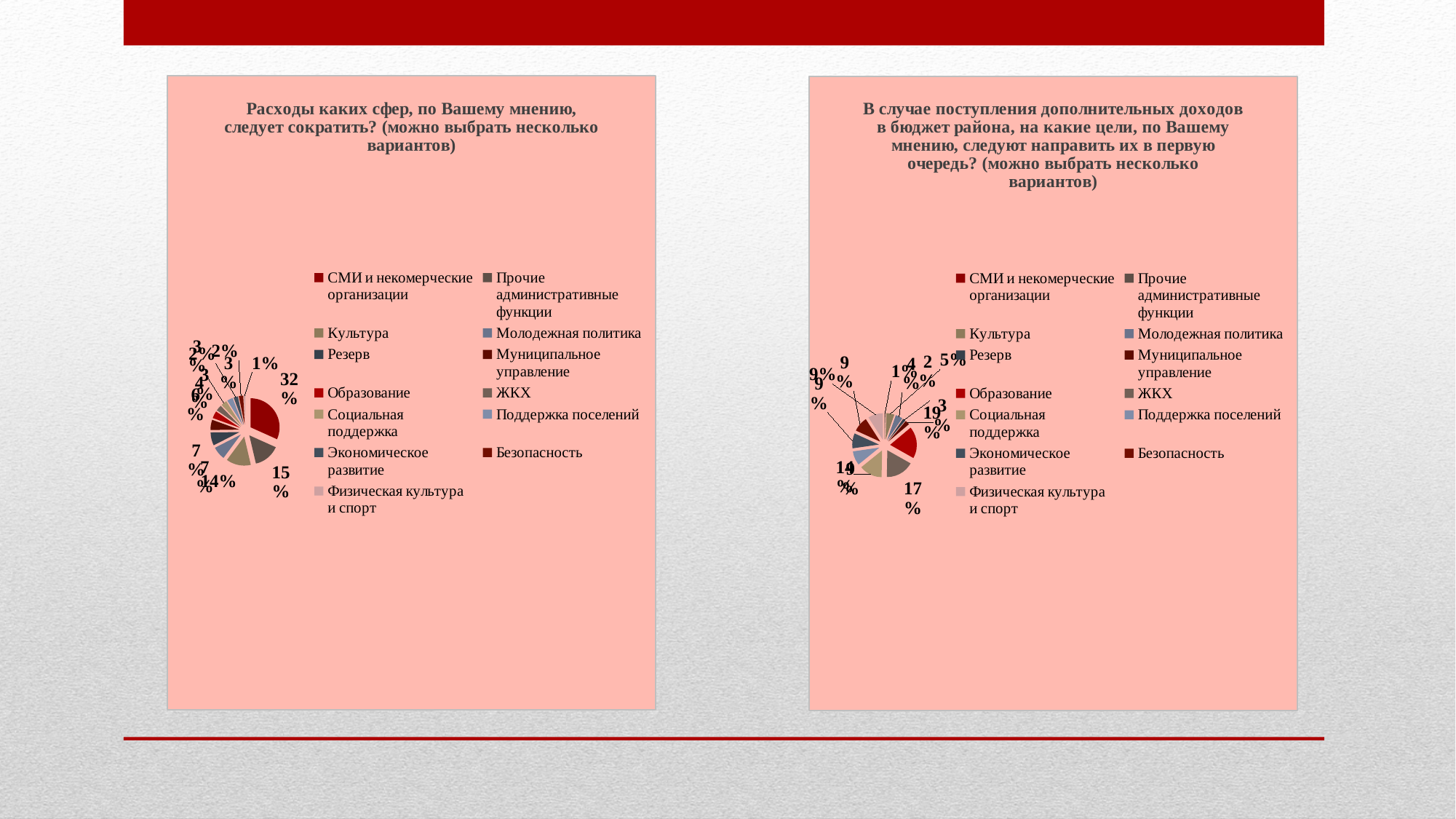
Which legend entry appears first in the legend of the left chart ("Расходы каких сфер... следует сократить?")? СМИ и некомерческие организации In the right chart ("В случае поступления дополнительных доходов..."), what is the largest percentage shown on any slice? 19% In the left chart ("Расходы каких сфер... следует сократить?"), what is the largest percentage shown on any slice? 32% In the left chart ("Расходы каких сфер... следует сократить?"), what share is shown for "СМИ и некомерческие организации"? 32% What kind of chart is the left chart titled "Расходы каких сфер, по Вашему мнению, следует сократить?"? pie chart In the left chart ("Расходы каких сфер... следует сократить?"), what is the smallest percentage shown on any slice? 1% Which chart has the larger biggest slice: the left chart ("Расходы каких сфер... следует сократить?") or the right chart ("В случае поступления дополнительных доходов...")? the left chart What kind of chart is the right chart about additional budget revenues ("В случае поступления дополнительных доходов...")? pie chart How many entries does the legend of the left chart ("Расходы каких сфер... следует сократить?") list? 13 How many entries does the legend of the right chart ("В случае поступления дополнительных доходов...") list? 13 In the right chart ("В случае поступления дополнительных доходов..."), is the largest slice greater or less than 20%? less In the left chart ("Расходы каких сфер... следует сократить?"), what is the difference between the largest slice (32%) and the second largest slice (15%)? 17%